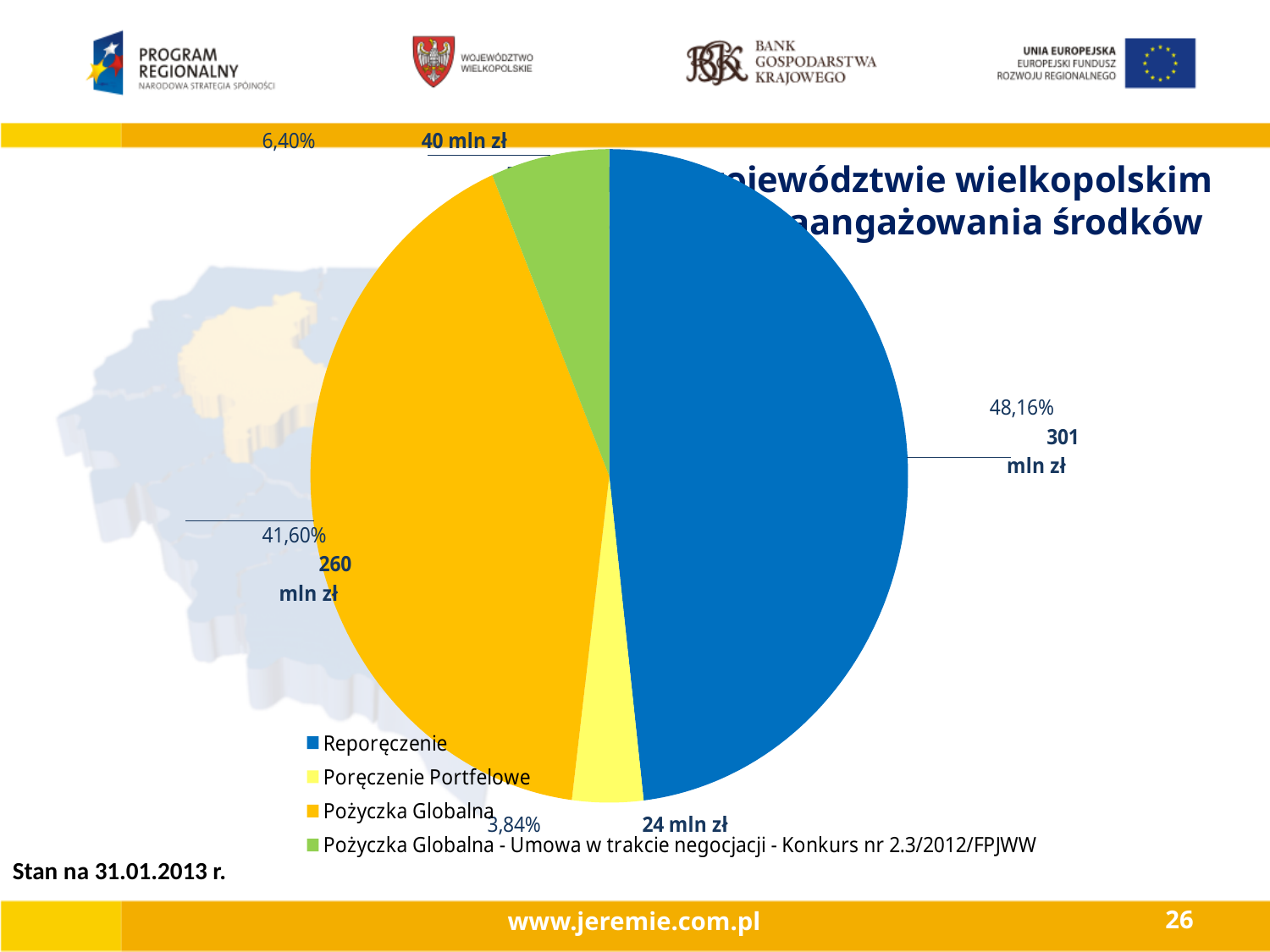
Which is larger: the share for Pożyczka Globalna or the share for Pożyczka Globalna - Umowa w trakcie negocjacji? Pożyczka Globalna What percentage share does Poręczenie Portfelowe have in the pie chart? 3,84% What value in mln zł is shown for Pożyczka Globalna? 260 mln zł What colour is the Reporęczenie slice in the pie chart? blue Which category has the largest slice in the pie chart? Reporęczenie How many entries does the legend of the pie chart list? 4 What kind of chart is shown on the slide? pie chart What is the difference in mln zł between Reporęczenie and Pożyczka Globalna? 41 mln zł What percentage share does Reporęczenie have in the pie chart? 48,16% How many slices does the pie chart have? 4 Which category has the smallest slice in the pie chart? Poręczenie Portfelowe What value in mln zł is shown for the slice labelled 6,40%? 40 mln zł